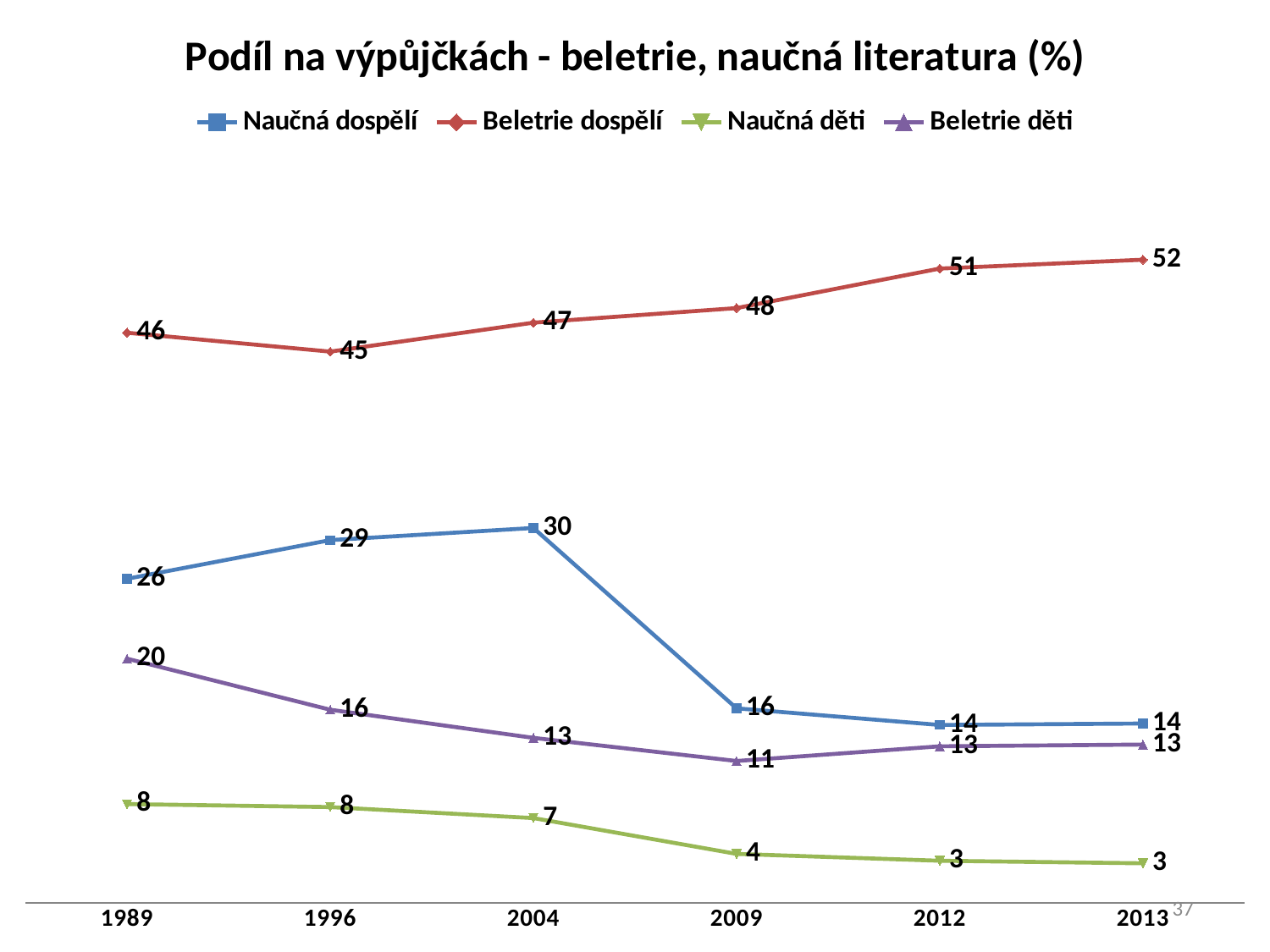
Does the Naučná děti series rise or fall from 1989 to 2013? Fall What kind of chart is this? Line chart In which year is the value for Beletrie dospělí lowest? 1996 What is the value for Naučná dospělí in 2004? 30 How many years are shown on the x axis? 6 Which is larger in 2012: Naučná dospělí or Beletrie děti? Naučná dospělí What is the value for Beletrie dospělí in 2013? 52 In which year is the value for Naučná dospělí highest? 2004 What is the value for Naučná děti in 2009? 4 How many series does the legend list? 4 What is the value for Beletrie děti in 1989? 20 What is the difference between the Naučná dospělí values in 2004 and 2009? 14